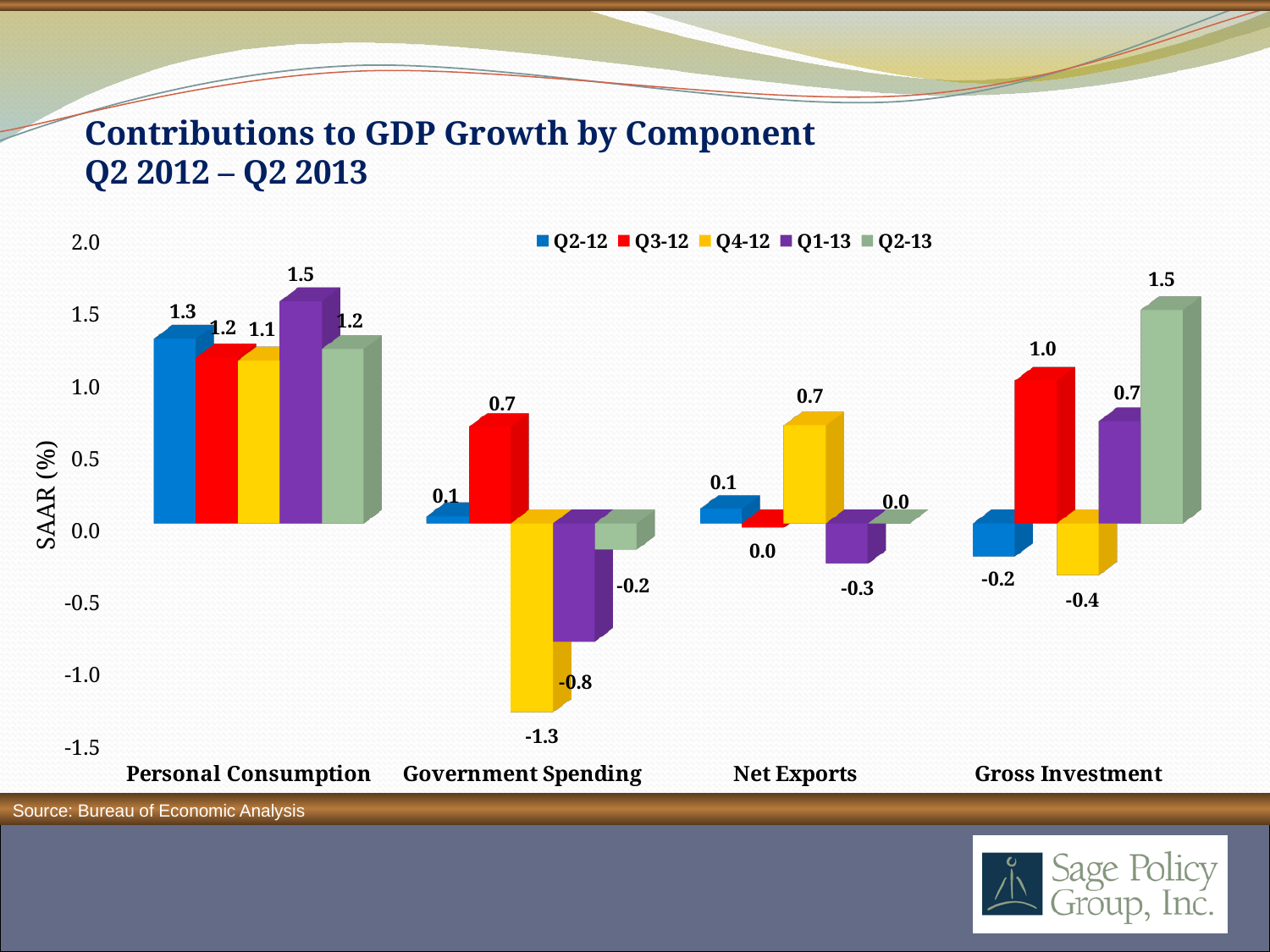
What kind of chart is shown on the slide? Bar chart How many categories are shown on the x axis? 4 Which is larger for Net Exports: the Q4-12 value or the Q2-12 value? Q4-12 Which quarter has the lowest value for Government Spending? Q4-12 What is the Q1-13 value for Net Exports? -0.3 What is the Q4-12 value for Government Spending? -1.3 How many series does the legend list? 5 What is the difference between the Q3-12 and Q4-12 values for Gross Investment? 1.4 What is the Q1-13 value for Personal Consumption? 1.5 What is the Q2-13 value for Gross Investment? 1.5 Which quarter has the highest value for Gross Investment? Q2-13 What is the label of the vertical axis? SAAR (%)